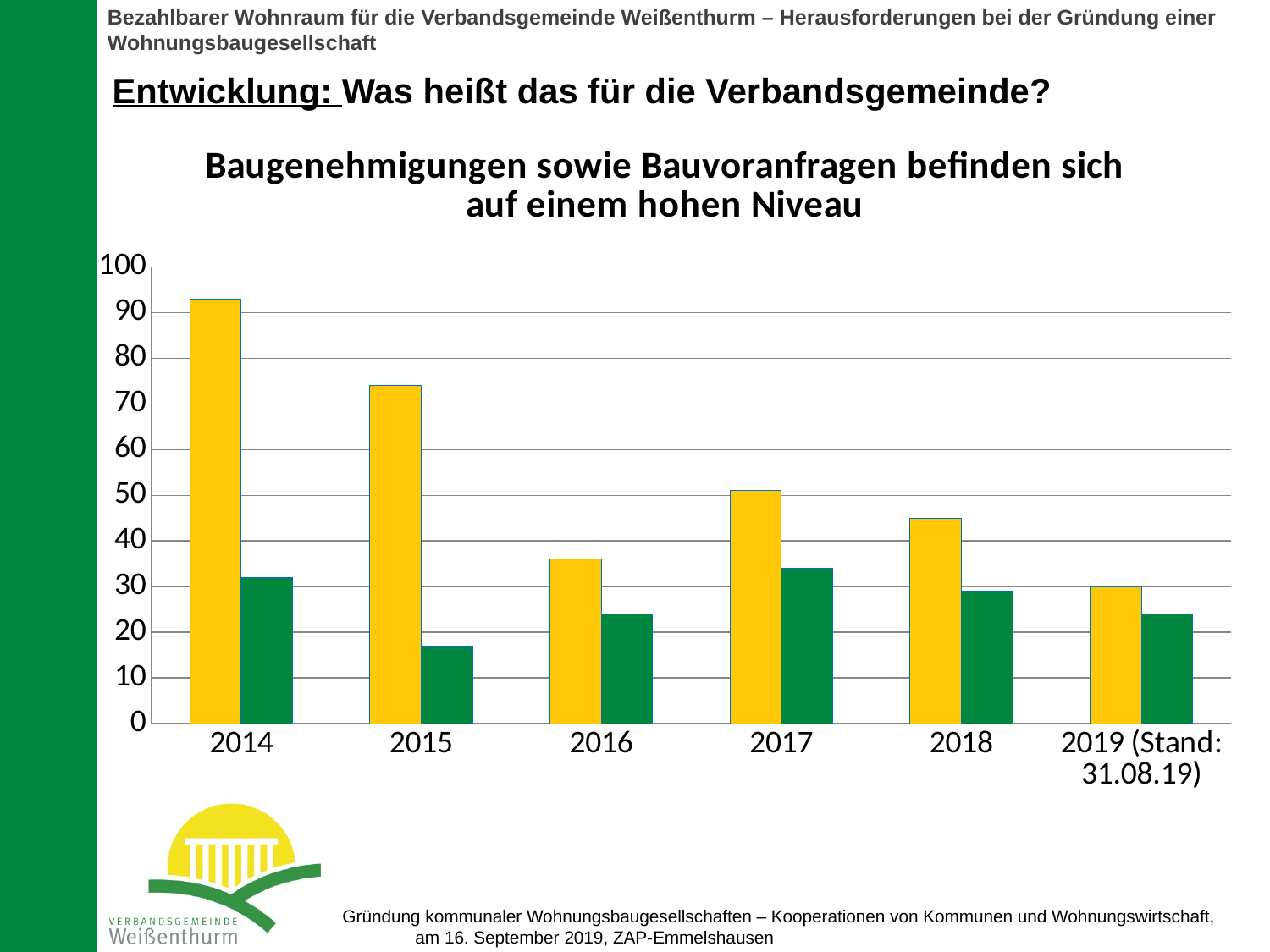
Is the value of the green bar for 2017 greater or less than 30? greater Is the value of the green bar for 2015 greater or less than 20? less Is the value of the yellow bar for 2018 greater or less than 50? less Which year has the shortest yellow bar? 2019 (Stand: 31.08.19) Which year has the tallest yellow bar? 2014 How many years (categories) are shown on the x axis of the chart? 6 Do the yellow bars overall rise or fall from 2014 to 2019? fall Which year has the shortest green bar? 2015 What kind of chart is shown on the slide? bar chart What is the title of the chart? Baugenehmigungen sowie Bauvoranfragen befinden sich auf einem hohen Niveau Which is larger, the yellow bar for 2016 or the yellow bar for 2017? 2017